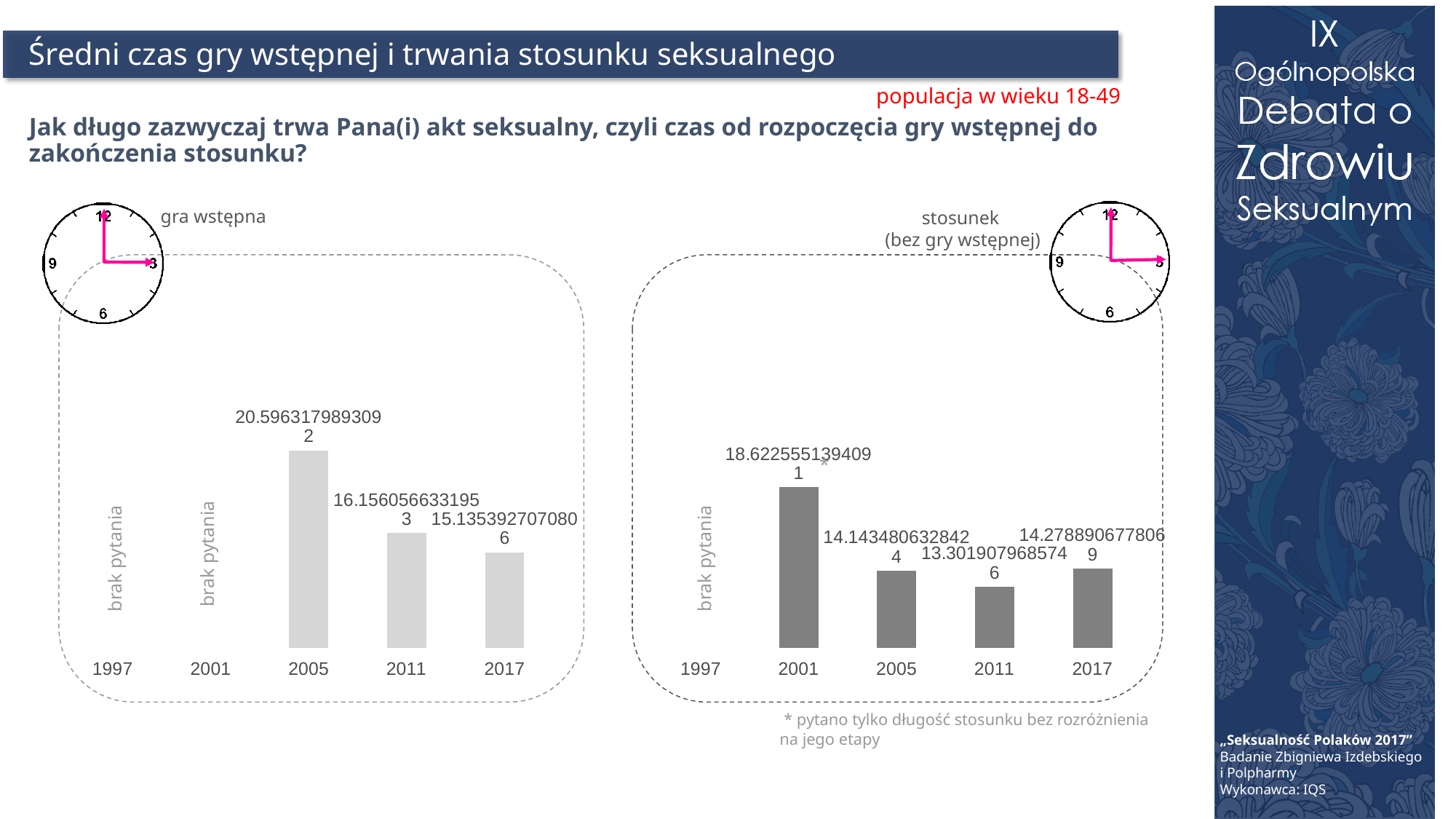
In the 'gra wstępna' chart, do the values rise or fall from 2005 to 2017? fall In the 'gra wstępna' chart, which year has the highest value? 2005 In the 'stosunek (bez gry wstępnej)' chart, is the value for 2001 larger or smaller than the value for 2005? larger In the 'stosunek (bez gry wstępnej)' chart, what is the value for 2001? 18.6225551394091 In the 'gra wstępna' chart, what is the value for 2005? 20.5963179893092 In the 'gra wstępna' chart, which years are marked 'brak pytania'? 1997 and 2001 In the 'gra wstępna' chart, how many years have a plotted bar? 3 In the 'stosunek (bez gry wstępnej)' chart, which year has the lowest value? 2011 In the 'gra wstępna' chart, which year has the lowest plotted value? 2017 What kind of chart is the 'gra wstępna' chart on the left? bar chart In the 'stosunek (bez gry wstępnej)' chart, how many years have a plotted bar? 4 In the 'stosunek (bez gry wstępnej)' chart, which year has the highest value? 2001